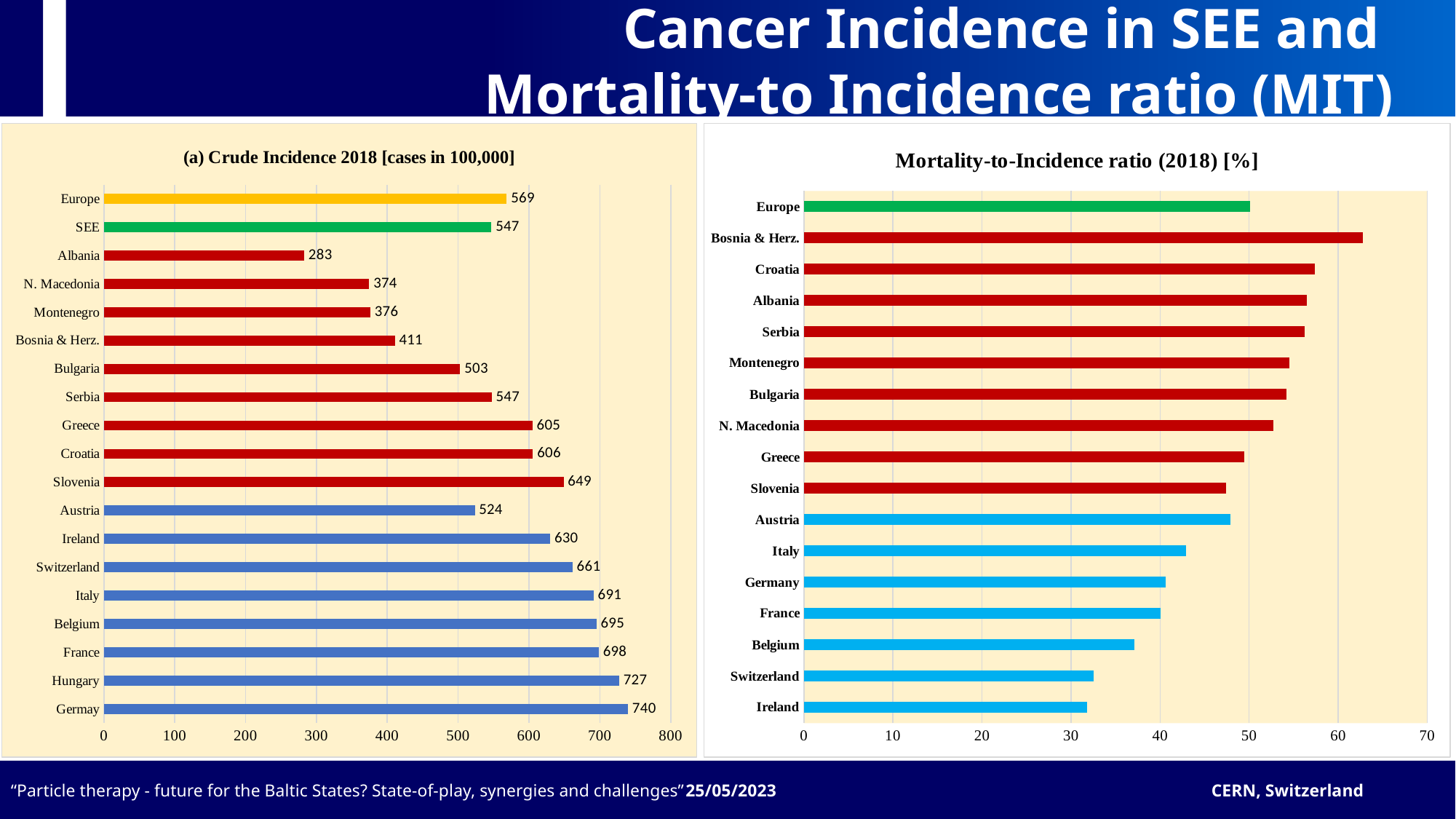
In the Mortality-to-Incidence ratio (2018) chart, is the value for Ireland greater or less than 40? less How many bars are plotted in the Crude Incidence 2018 chart? 19 In the Crude Incidence 2018 chart, what is the value for Germany? 740 In the Mortality-to-Incidence ratio (2018) chart, which country has the highest value? Bosnia & Herz. In the Crude Incidence 2018 chart, which country has the highest value? Germany In the Mortality-to-Incidence ratio (2018) chart, is the value for Bosnia & Herz. greater or less than 60? greater What kind of chart is the Mortality-to-Incidence ratio (2018) chart? bar chart How many bars are plotted in the Mortality-to-Incidence ratio (2018) chart? 17 In the Crude Incidence 2018 chart, which has a larger value, Hungary or Slovenia? Hungary In the Crude Incidence 2018 chart, which country has the lowest value? Albania In the Crude Incidence 2018 chart, what is the value for Albania? 283 In the Crude Incidence 2018 chart, what is the difference between the values for Europe and SEE? 22